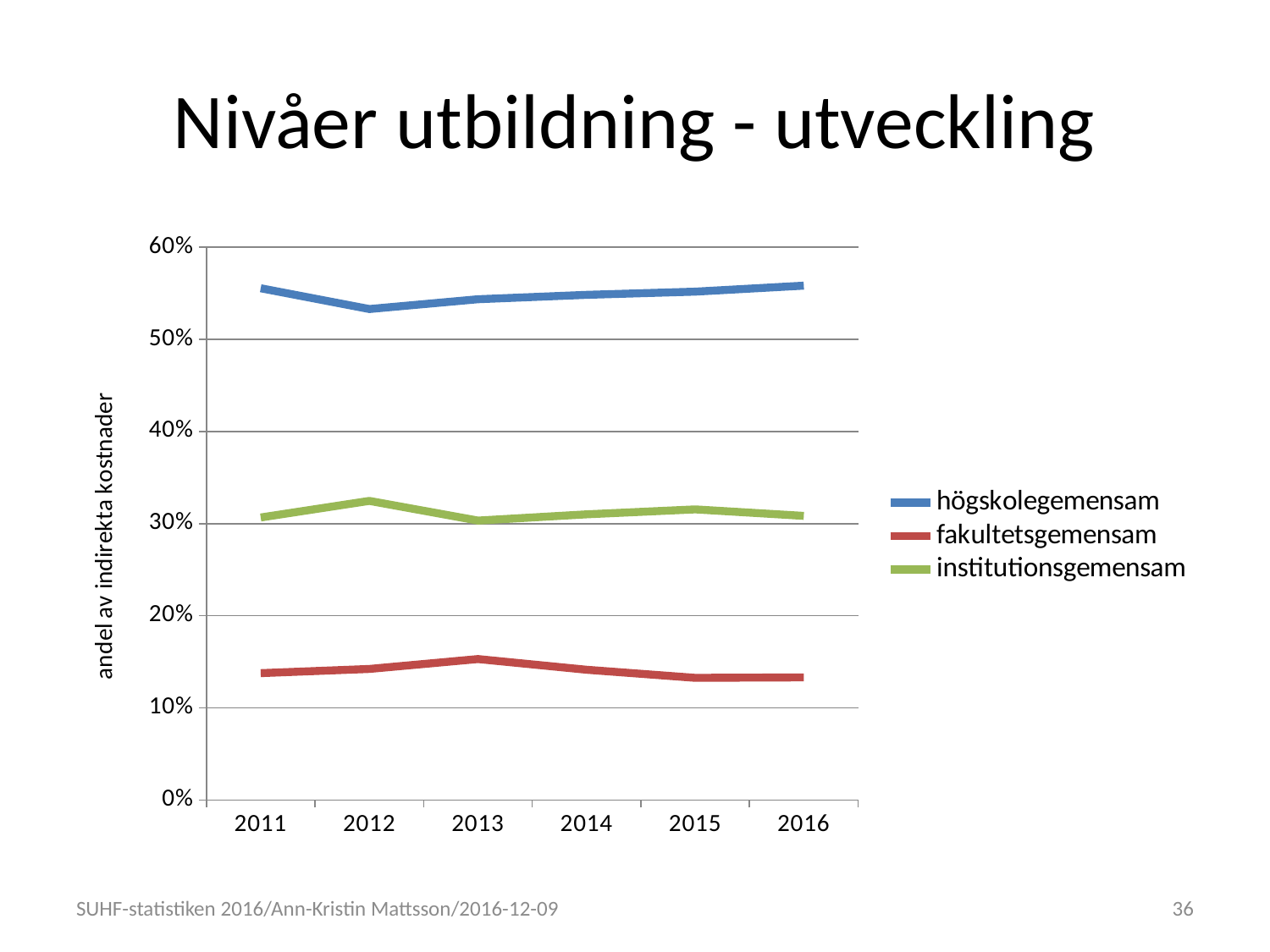
What is the title of the slide? Nivåer utbildning - utveckling Which series has the highest values across all years? högskolegemensam What kind of chart is shown on the slide? line chart What is the label on the vertical axis? andel av indirekta kostnader Is the value for fakultetsgemensam in 2013 greater or less than 20%? less How many years are shown on the x axis? 6 Which is larger in 2016, institutionsgemensam or fakultetsgemensam? institutionsgemensam Is the value for institutionsgemensam in 2012 greater or less than 30%? greater Does the högskolegemensam line rise or fall from 2012 to 2016? rise How many series does the legend list? 3 Which series has the lowest values across all years? fakultetsgemensam Is the value for högskolegemensam in 2012 greater or less than 50%? greater